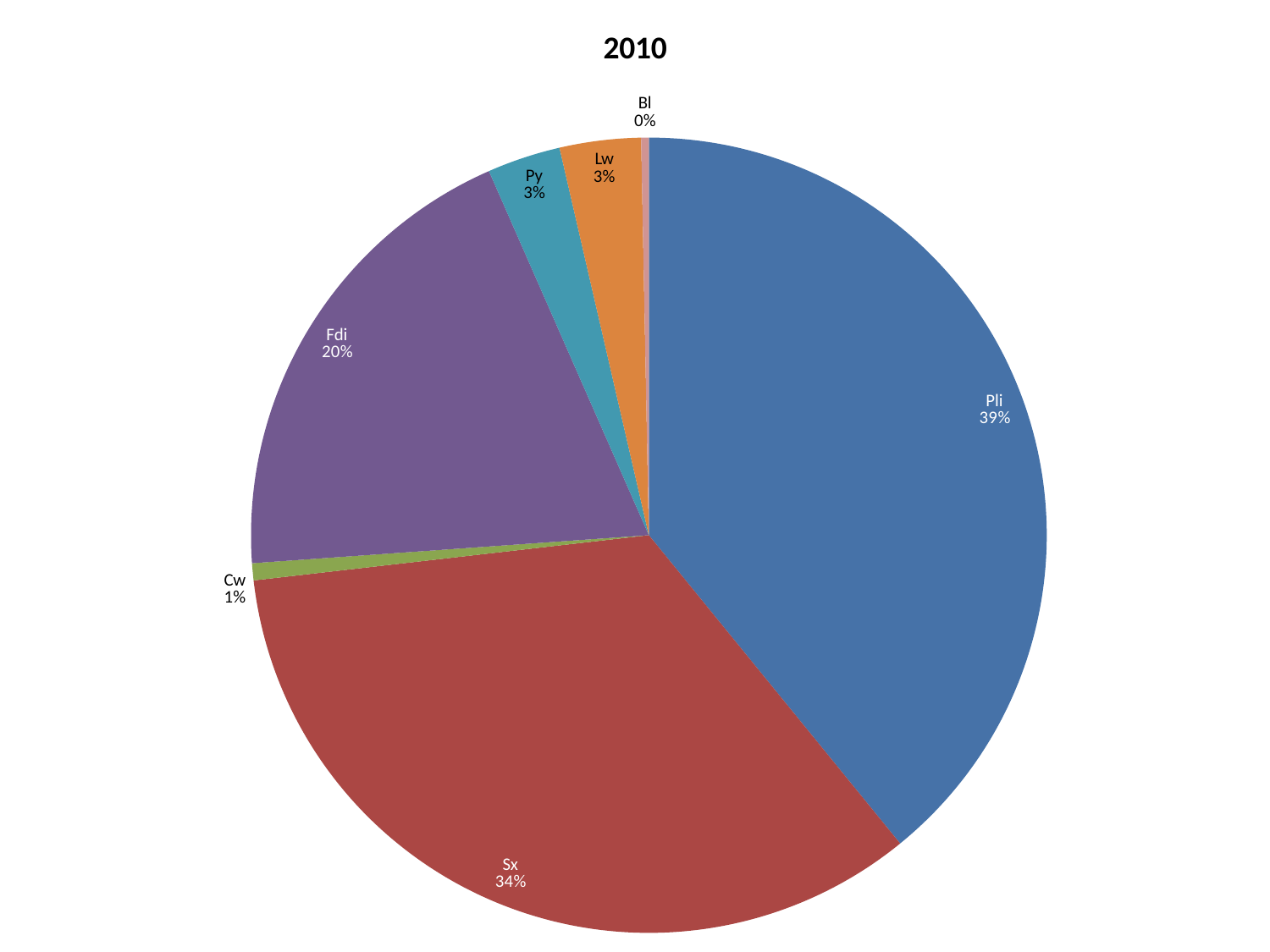
How many slices does the pie chart have? 7 What share of the pie does Cw have? 1% What is the title of the chart? 2010 What share of the pie does Fdi have? 20% Which category has the largest slice of the pie? Pli What kind of chart is shown on the slide? pie chart Which category has the smallest slice of the pie? Bl What share of the pie does Sx have? 34% Which slice is larger, Fdi or Py? Fdi What is the difference in percentage points between the Pli and Sx slices? 5